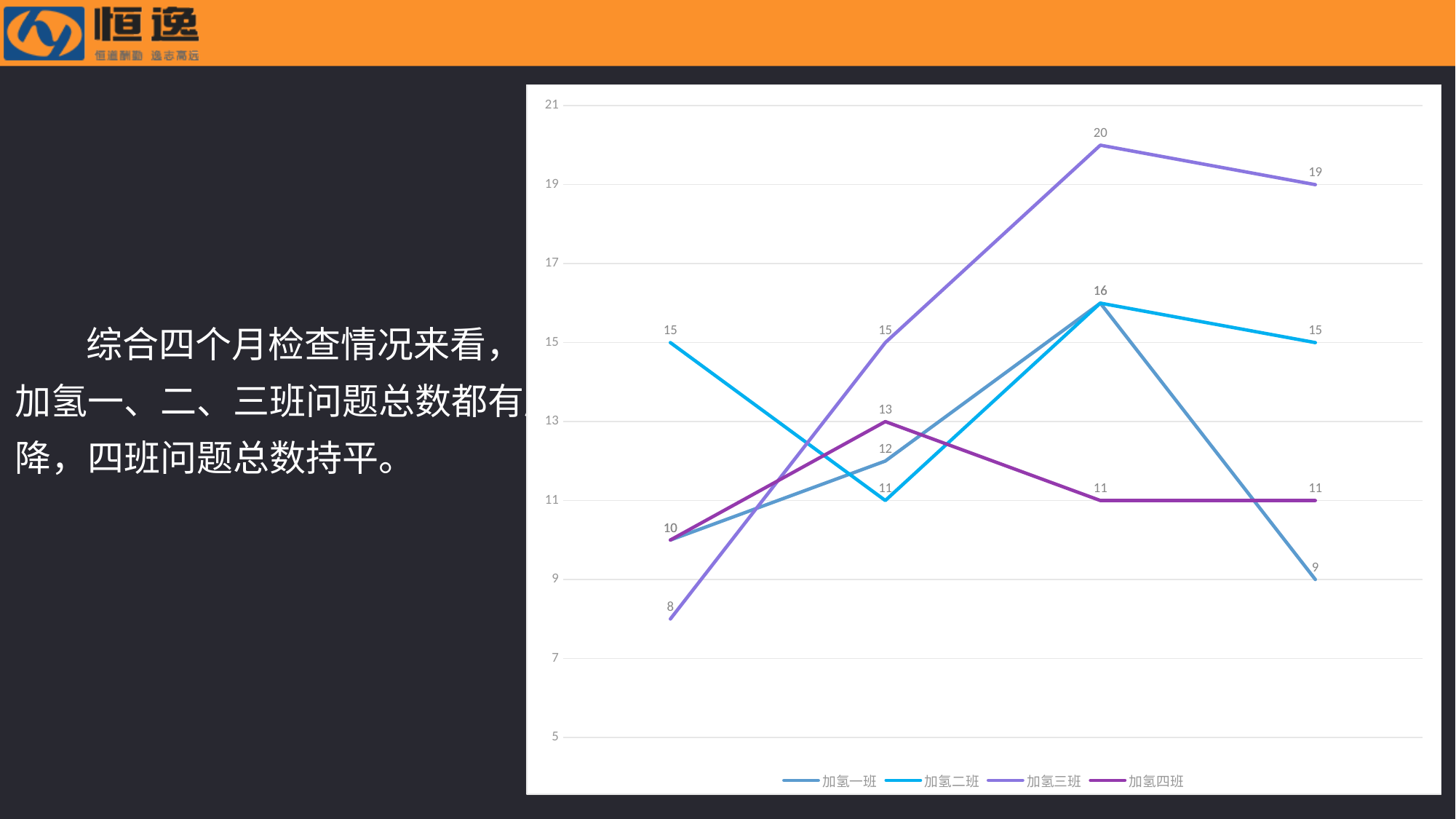
What is the value of 加氢二班 at the first point? 15 How many data points does each line in the chart have? 4 What kind of chart is shown on the slide? line chart How many series does the chart legend list? 4 Does the 加氢三班 line rise or fall from the first point to the third point? rise What is the value of 加氢三班 at the third point? 20 Which series reaches the highest value on the chart? 加氢三班 Which series has the lowest value on the chart? 加氢三班 At the last point, which is larger: 加氢二班 or 加氢四班? 加氢二班 What is the value of 加氢一班 at the last point? 9 What is the value of 加氢四班 at the second point? 13 What is the difference between the first and last values of 加氢三班? 11